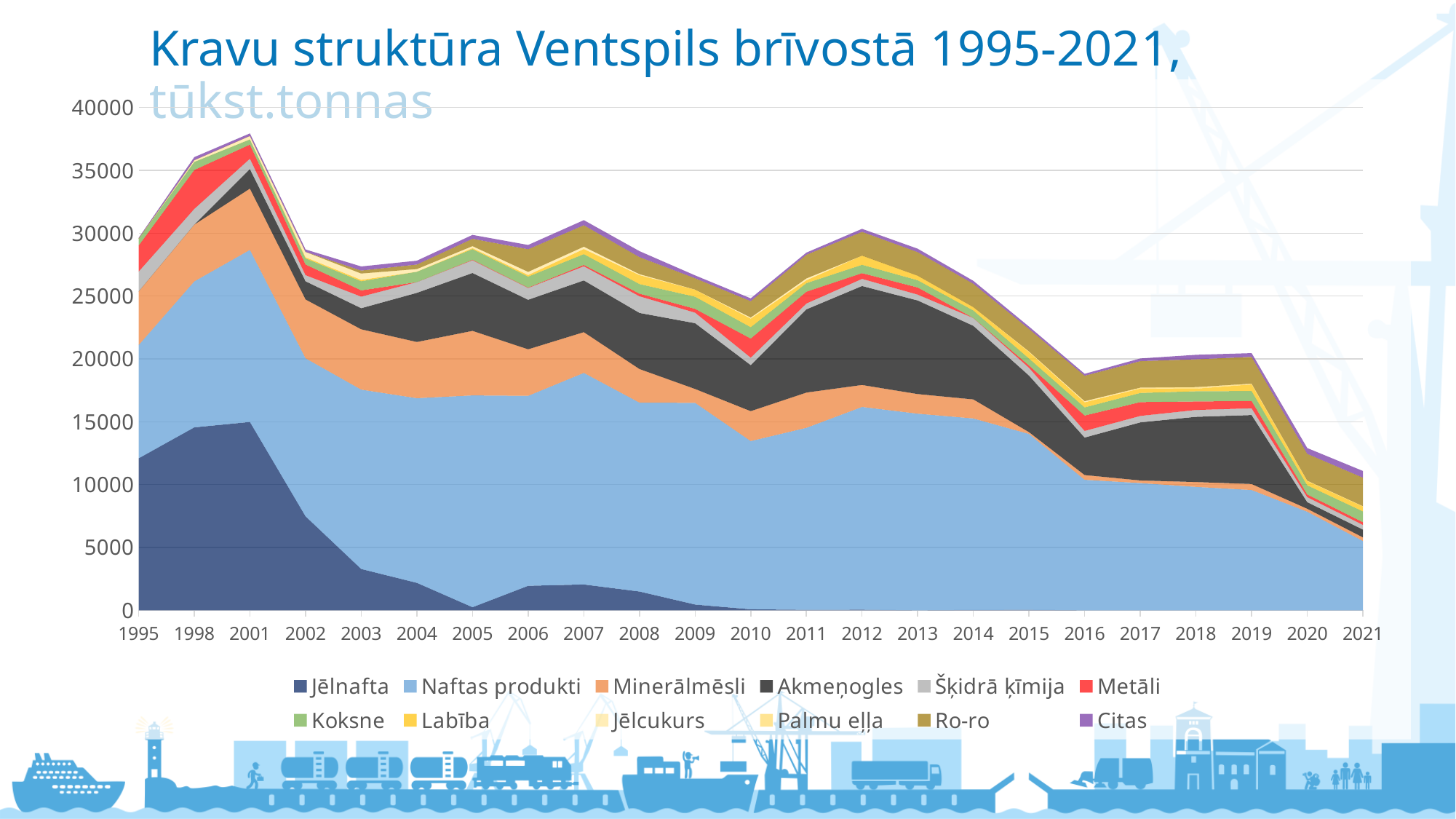
What is the title of the chart? Kravu struktūra Ventspils brīvostā 1995-2021, tūkst.tonnas Does the total cargo volume rise or fall from 2012 to 2021? fall Is the value for Jēlnafta in 2001 greater or less than 10000? greater How many series does the legend list? 12 How many years are shown along the x axis? 23 Which year has the larger total cargo volume, 2001 or 2021? 2001 In which year is the total cargo volume lowest? 2021 What kind of chart is shown on the slide? Stacked area chart Is the total cargo volume in 2021 greater or less than 15000? less Is the total cargo volume in 2012 greater or less than 25000? greater In which year is the total cargo volume highest? 2001